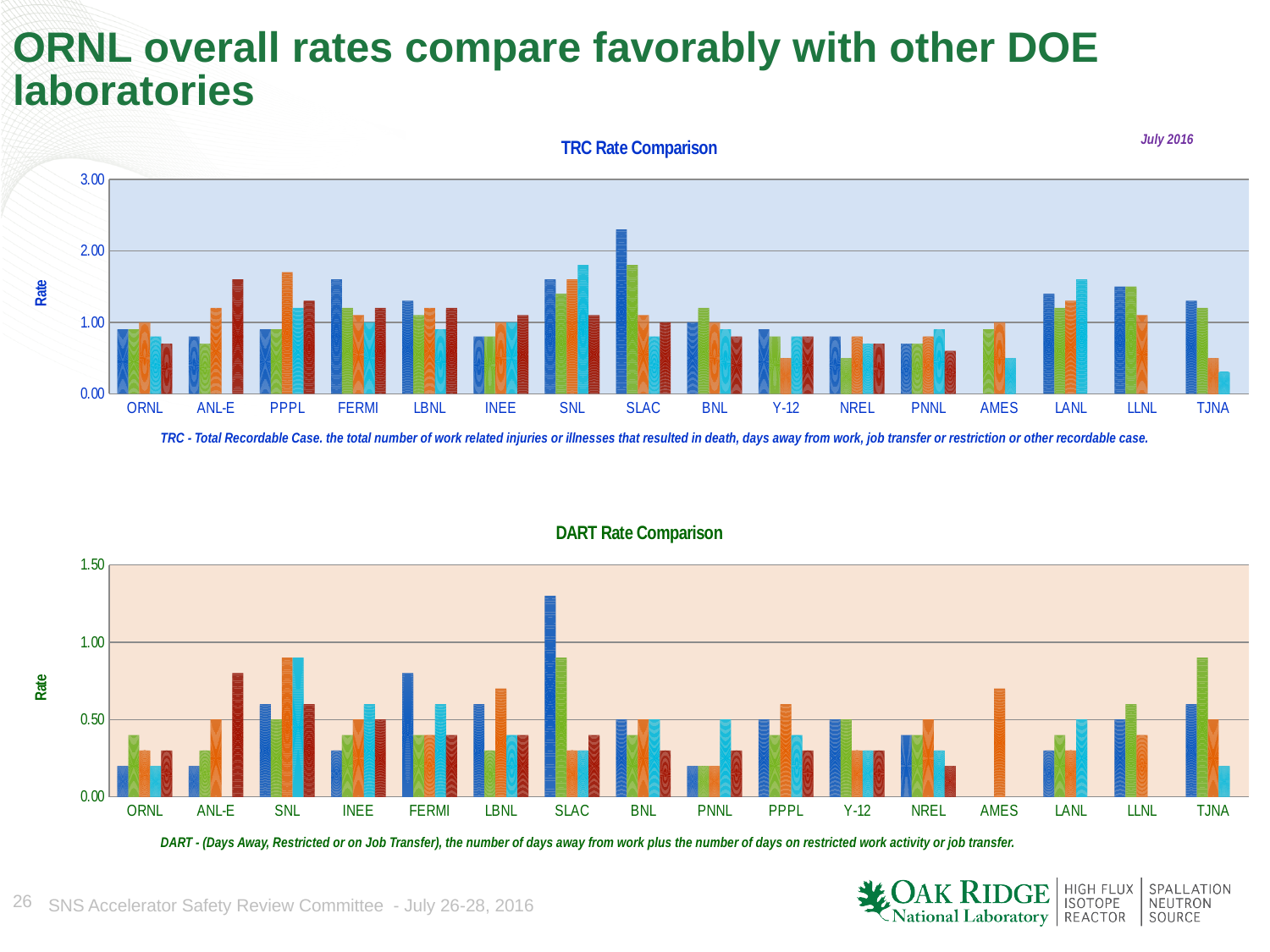
How many laboratories are shown on the x axis of the DART Rate Comparison chart? 16 What is the highest value shown on the y axis of the TRC Rate Comparison chart? 3.00 In the DART Rate Comparison chart, is the tallest bar for SLAC greater or less than 1.00? greater In the DART Rate Comparison chart, is the bar for AMES greater or less than 0.50? greater In the TRC Rate Comparison chart, is the tallest bar for LANL greater or less than 1.00? greater What kind of chart is the TRC Rate Comparison chart? bar chart How many laboratories are shown on the x axis of the TRC Rate Comparison chart? 16 In the TRC Rate Comparison chart, which laboratory has the single tallest bar? SLAC In the DART Rate Comparison chart, which laboratory has the single tallest bar? SLAC What is the y-axis label on the DART Rate Comparison chart? Rate